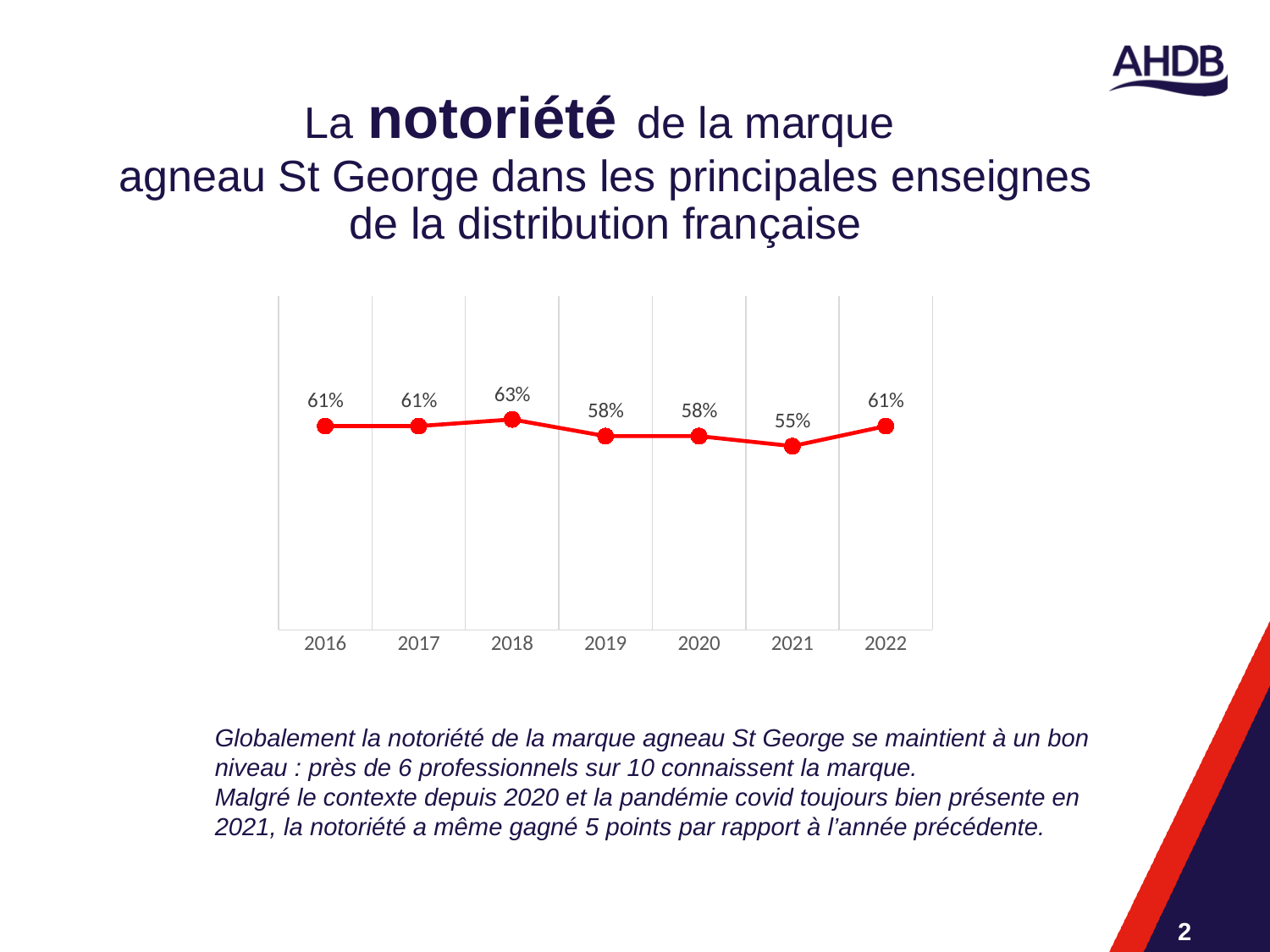
Which year has the lowest value? 2021 What is the value for 2019? 58% What is the difference between the values for 2022 and 2021? 6% Do the values rise or fall from 2018 to 2021? fall What is the value for 2018? 63% Which year has the highest value? 2018 Which is larger, the value for 2016 or the value for 2020? 2016 What is the difference between the values for 2018 and 2019? 5% What is the value for 2021? 55% What is the value for 2022? 61% What kind of chart is shown on the slide? line chart How many years are plotted on the chart? 7